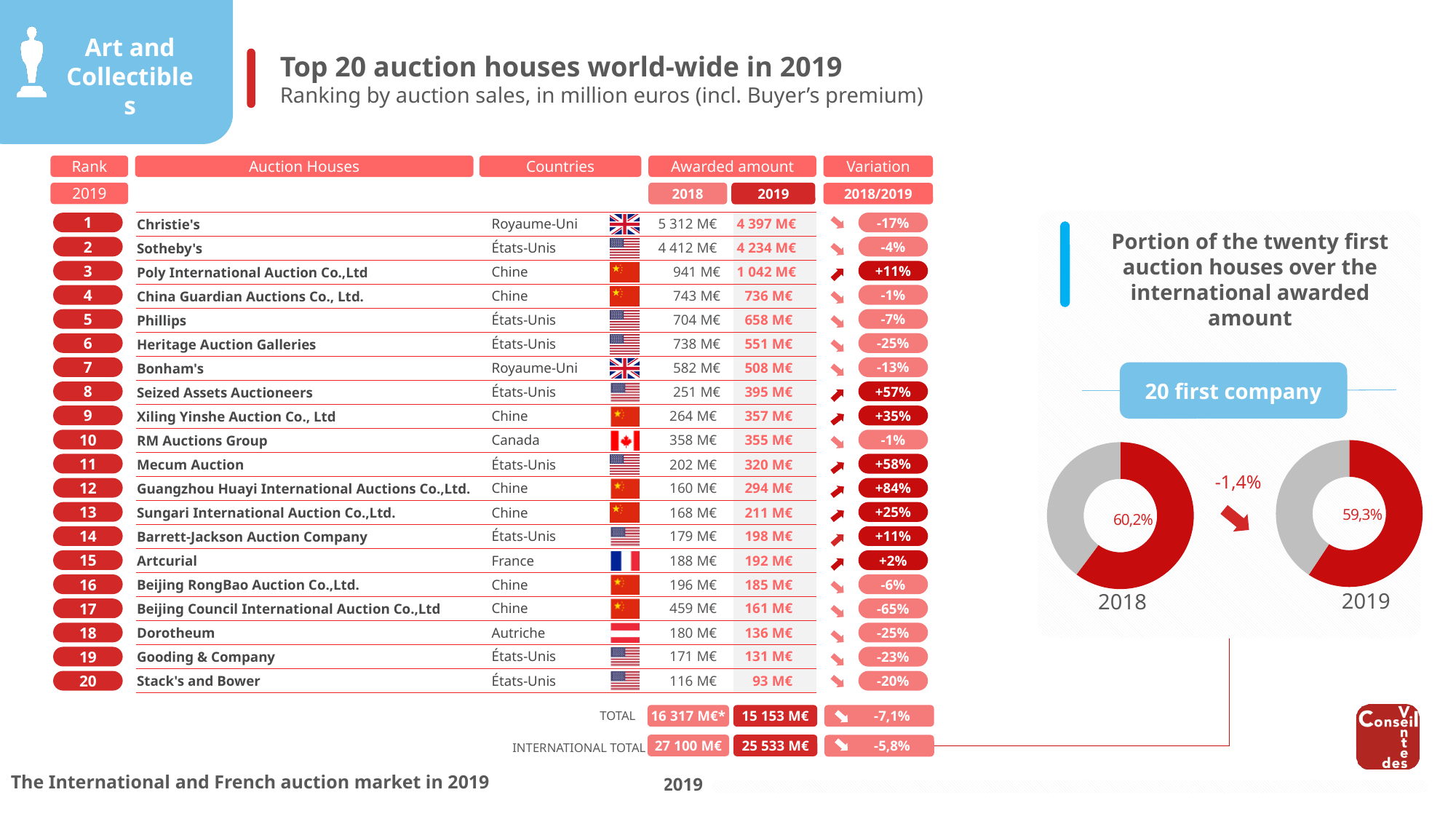
What kind of charts are used to show the portion of the twenty first auction houses over the international awarded amount? Donut (pie) charts What label appears in the blue box above the donut charts? 20 first company In the donut charts, what portion of the international awarded amount did the 20 first auction houses represent in 2018? 60,2% In the donut charts, what portion of the international awarded amount did the 20 first auction houses represent in 2019? 59,3% What variation is printed between the 2018 and 2019 donut charts? -1,4% Does the portion of the 20 first companies rise or fall from the 2018 donut to the 2019 donut? Fall In the table, what was Christie's awarded amount in 2019? 4 397 M€ In the table, which auction house has the highest 2018/2019 variation? Guangzhou Huayi International Auctions Co.,Ltd. (+84%) In the donut charts, which year shows the larger portion for the 20 first companies, 2018 or 2019? 2018 How many donut charts are shown on the slide? 2 In the 2019 donut chart, is the portion of the 20 first companies greater or less than 50%? greater What is the title above the donut charts? Portion of the twenty first auction houses over the international awarded amount